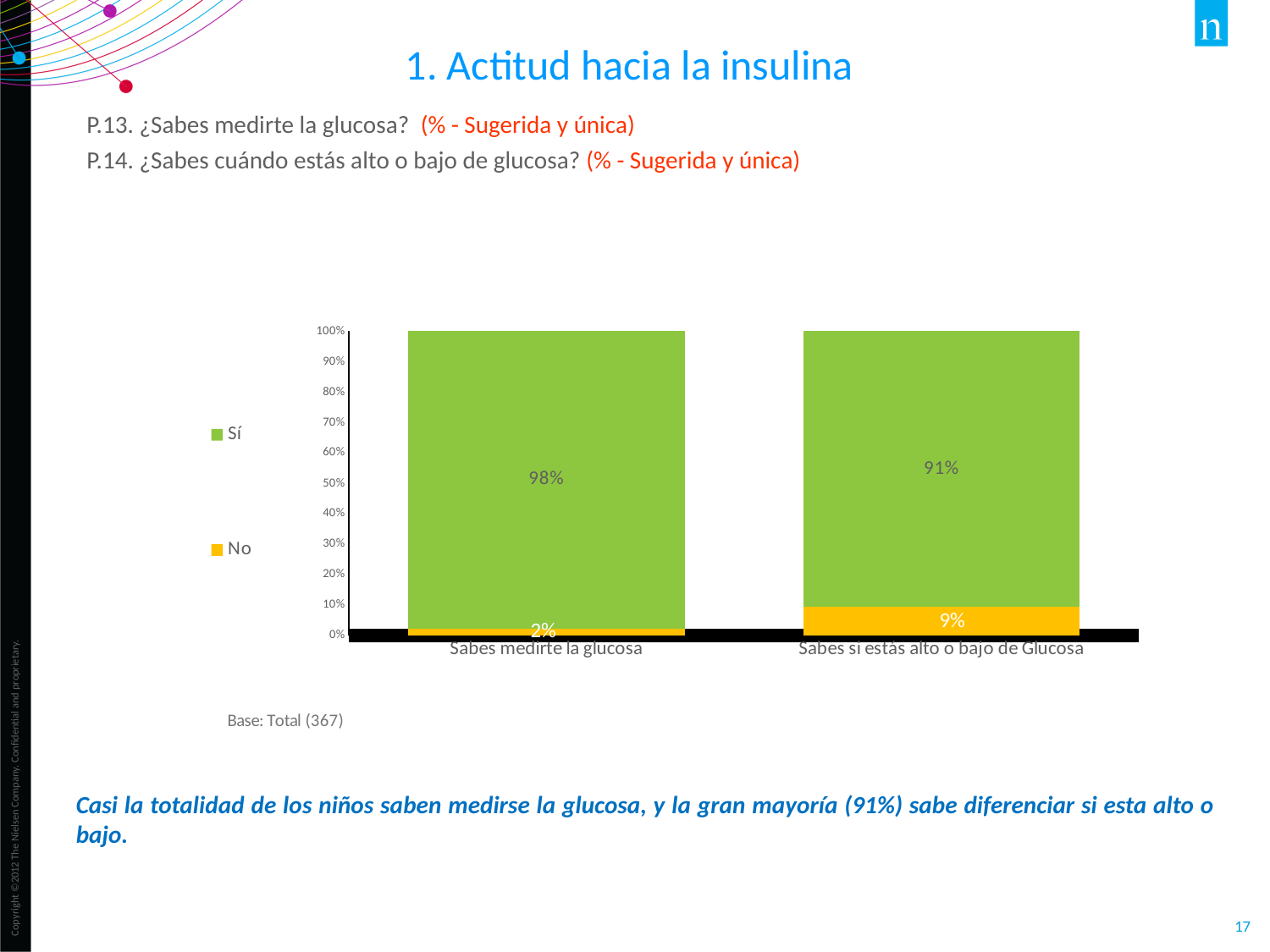
Which category has the lower "No" percentage? Sabes medirte la glucosa How many series does the chart legend list? 2 What is the difference between the "Sí" values for "Sabes medirte la glucosa" and "Sabes si estás alto o bajo de Glucosa"? 7 percentage points Is the "No" value larger for "Sabes medirte la glucosa" or for "Sabes si estás alto o bajo de Glucosa"? Sabes si estás alto o bajo de Glucosa What percentage of respondents answered "Sí" for "Sabes medirte la glucosa"? 98% What is the "No" value for "Sabes medirte la glucosa"? 2% Which category has the higher "Sí" percentage? Sabes medirte la glucosa What type of chart is shown on the slide? Stacked bar chart Which colour represents the "No" series in the chart? Yellow How many categories are shown on the x axis of the chart? 2 What percentage of respondents answered "No" for "Sabes si estás alto o bajo de Glucosa"? 9% What is the "Sí" value for "Sabes si estás alto o bajo de Glucosa"? 91%